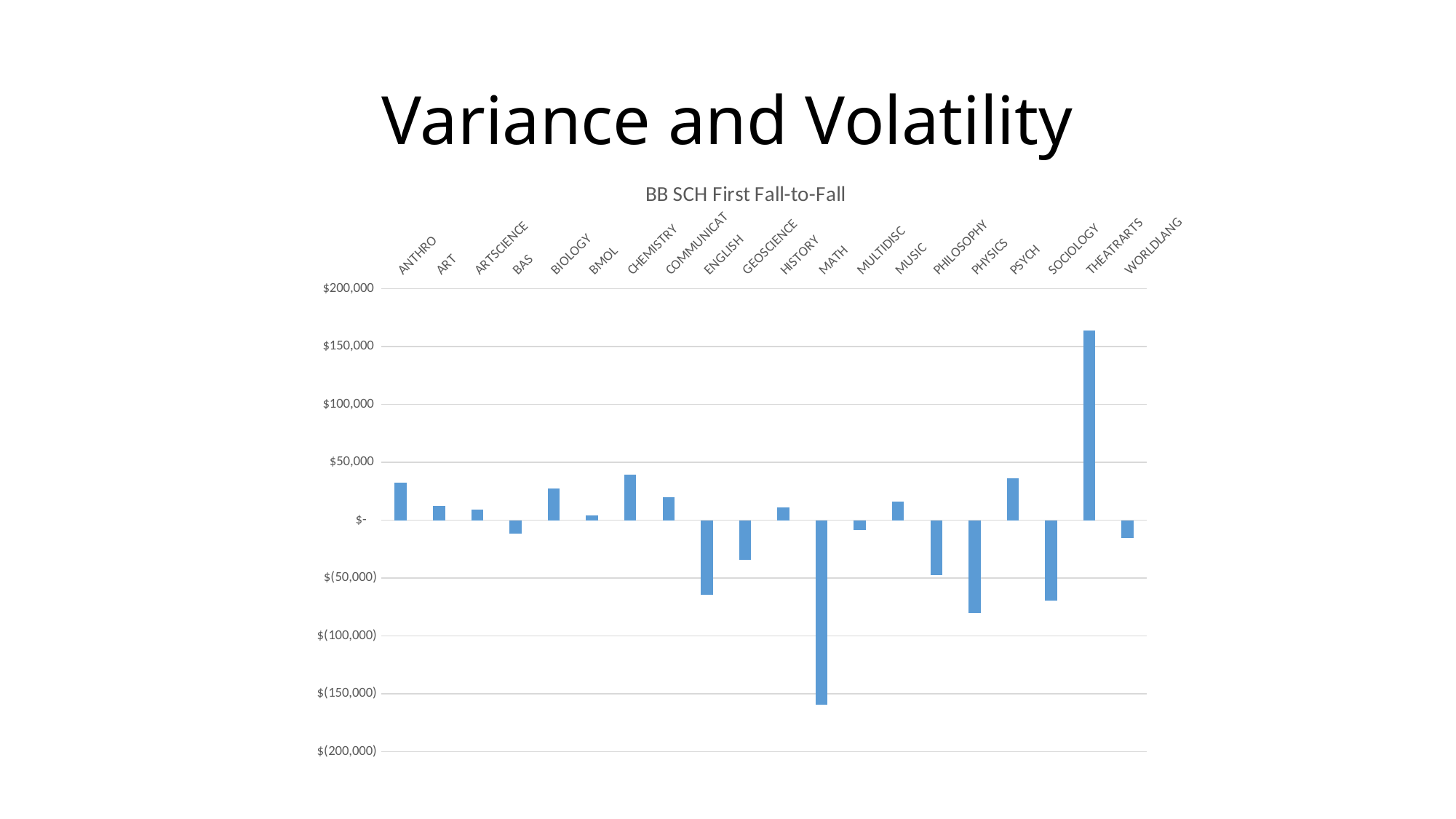
What kind of chart is shown on the slide? bar chart Which has the larger value, ANTHRO or ART? ANTHRO Is the value for PHYSICS greater or less than $(50,000)? less Which has the larger value, CHEMISTRY or BMOL? CHEMISTRY Is the value for THEATRARTS greater or less than $150,000? greater Which category has the highest value in the chart? THEATRARTS How many categories are plotted on the x axis of the chart? 20 What is the title of the chart? BB SCH First Fall-to-Fall Is the value for COMMUNICAT greater or less than $(50,000)? greater Which category has the lowest value in the chart? MATH